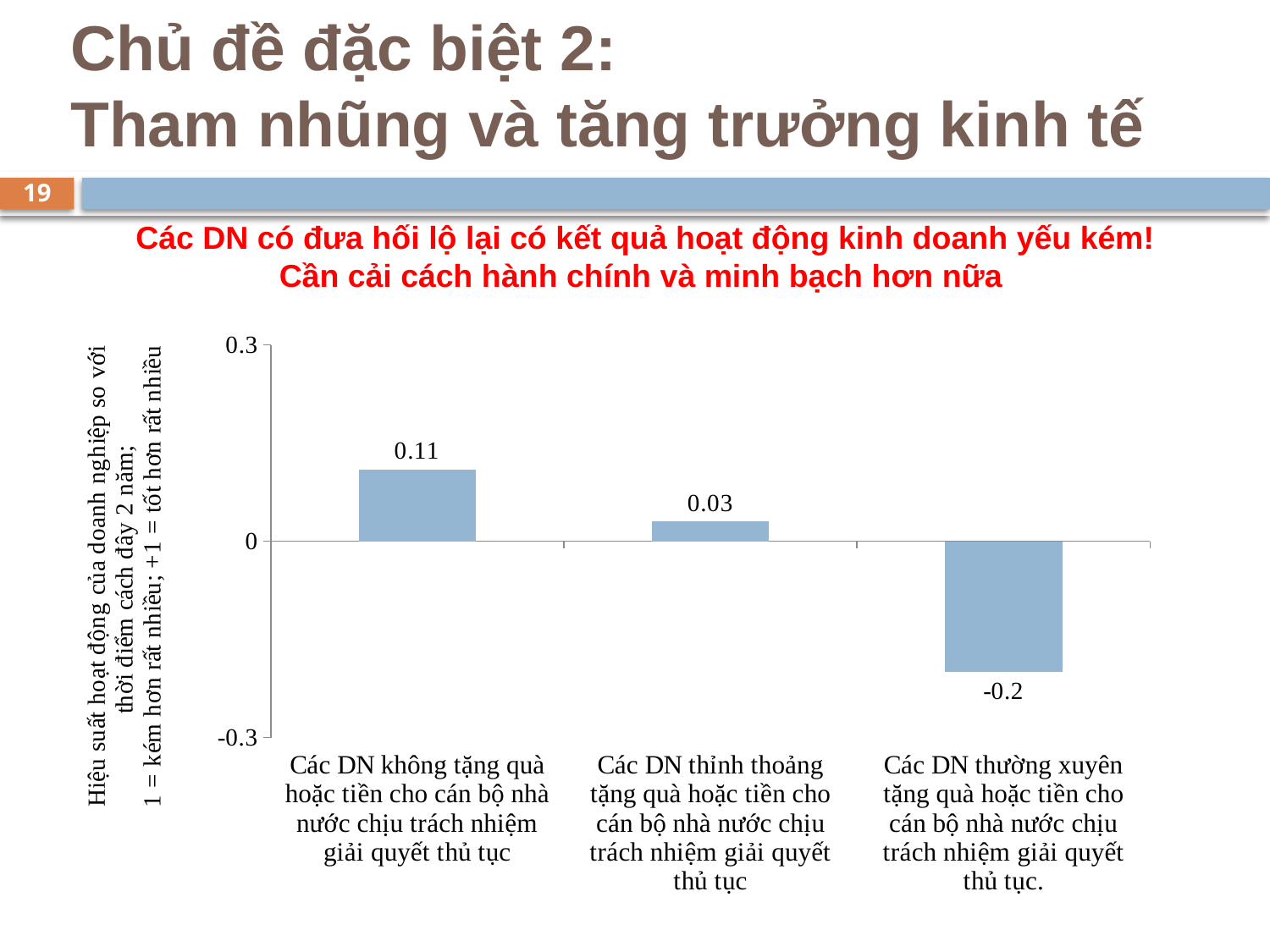
What is the maximum value shown on the vertical axis? 0.3 Which category has the lowest value? Các DN thường xuyên tặng quà hoặc tiền cho cán bộ nhà nước chịu trách nhiệm giải quyết thủ tục How many categories are shown on the x axis? 3 What is the value for 'Các DN thường xuyên tặng quà hoặc tiền cho cán bộ nhà nước chịu trách nhiệm giải quyết thủ tục'? -0.2 What is the value for 'Các DN thỉnh thoảng tặng quà hoặc tiền cho cán bộ nhà nước chịu trách nhiệm giải quyết thủ tục'? 0.03 Which is larger: the value for 'Các DN không tặng quà' or the value for 'Các DN thỉnh thoảng tặng quà'? Các DN không tặng quà Which category has the highest value? Các DN không tặng quà hoặc tiền cho cán bộ nhà nước chịu trách nhiệm giải quyết thủ tục Do the values rise or fall from left to right along the x axis? fall What is the difference between the value for firms that never give gifts (0.11) and firms that occasionally give gifts (0.03)? 0.08 Is the value for 'Các DN thường xuyên tặng quà hoặc tiền' greater or less than 0? less What is the value for 'Các DN không tặng quà hoặc tiền cho cán bộ nhà nước chịu trách nhiệm giải quyết thủ tục'? 0.11 What kind of chart is shown on the slide? bar chart